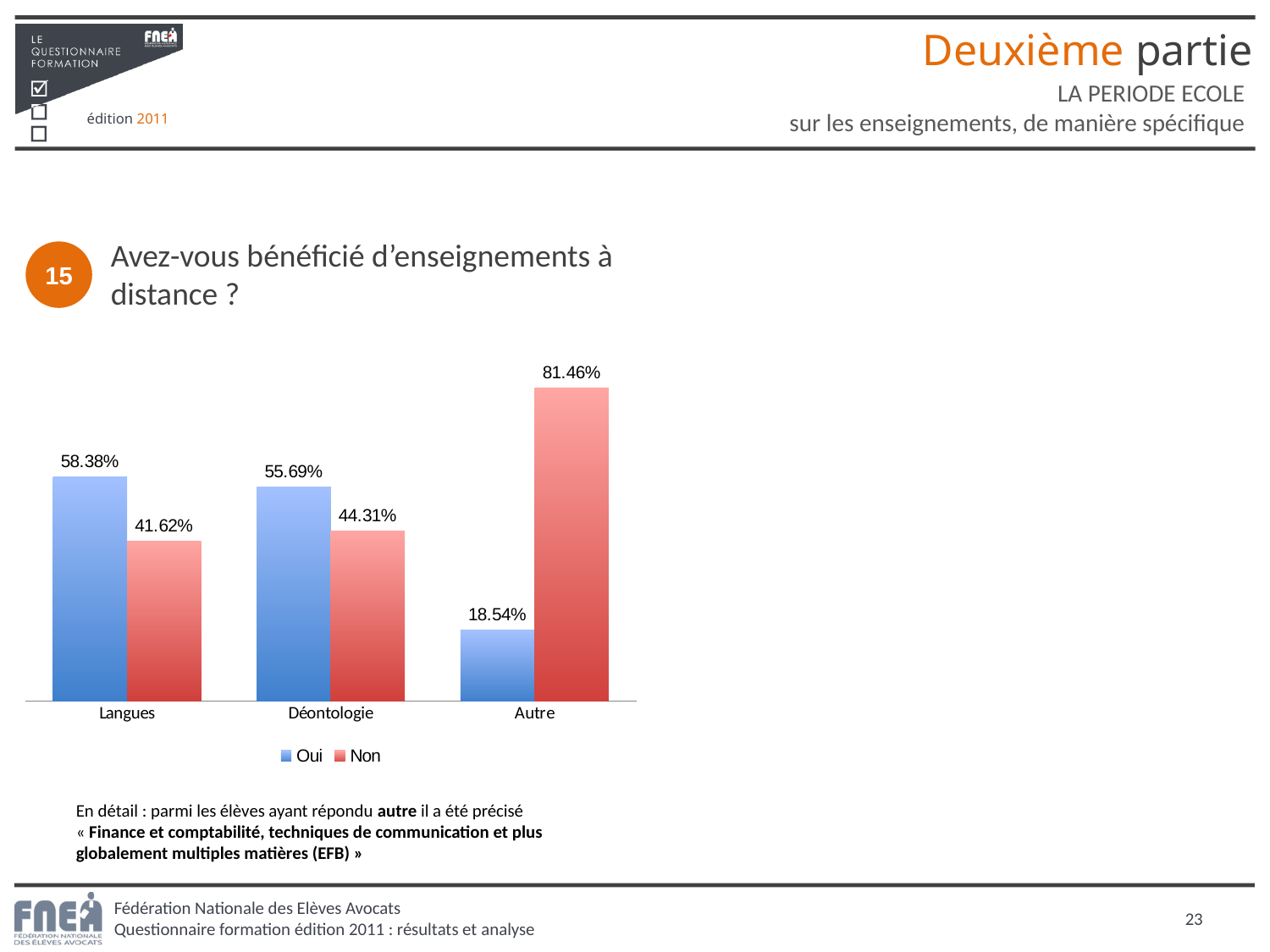
Which is larger for Déontologie: 'Oui' or 'Non'? Oui Which colour represents the 'Non' series in the legend? Red What is the difference between the 'Oui' and 'Non' values for Langues? 16.76% How many series does the legend list? 2 What is the 'Non' value for Autre? 81.46% How many categories are shown on the x axis? 3 What kind of chart is shown on the slide? Bar chart What is the 'Non' value for Déontologie? 44.31% Which category has the highest 'Oui' value? Langues Does the 'Non' value rise or fall from Langues to Autre? Rises What is the 'Oui' value for Langues? 58.38% Which category has the lowest 'Oui' value? Autre